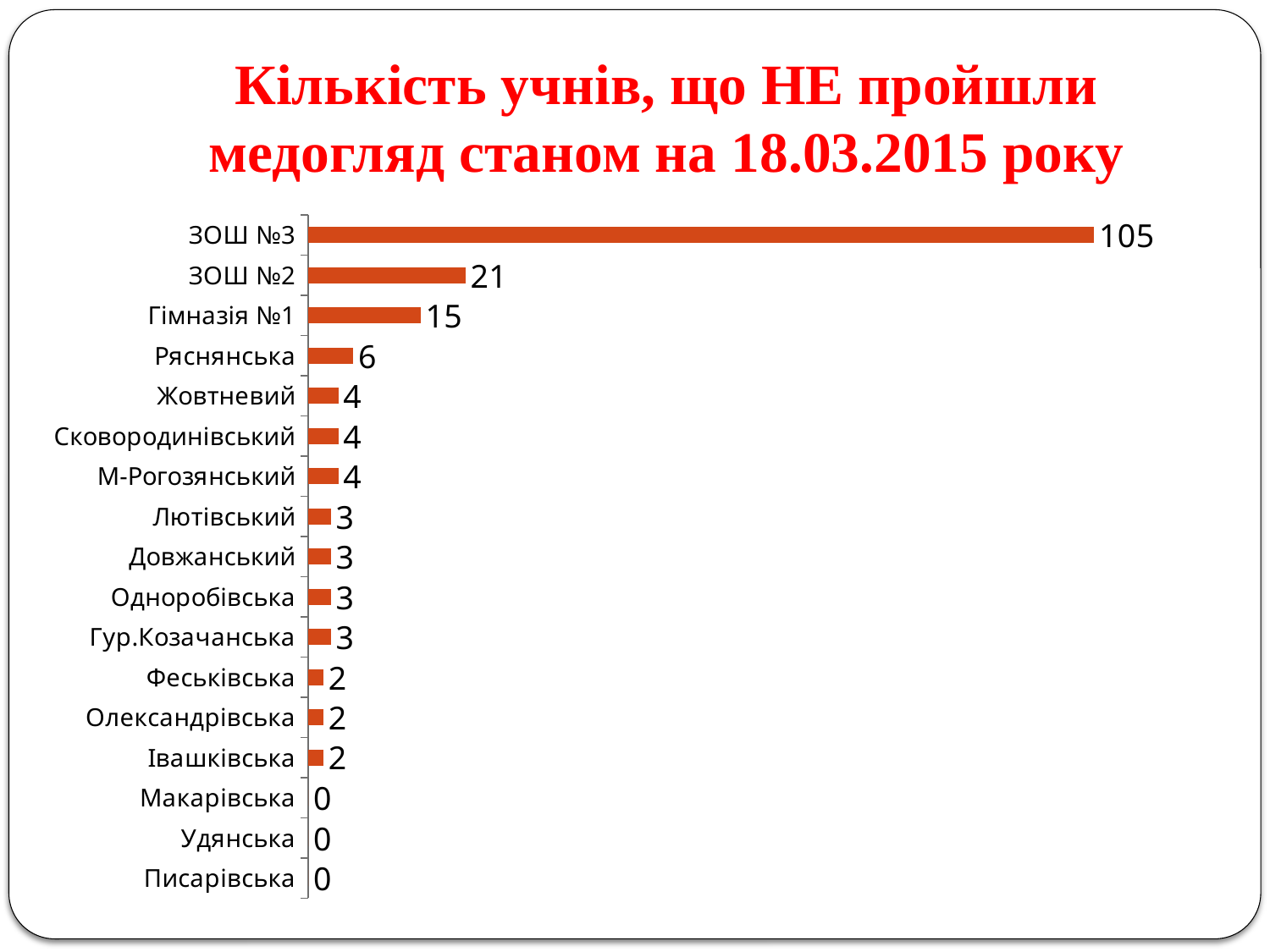
How many categories are shown in the chart? 17 What is the value for ЗОШ №3? 105 What is the title of the chart on the slide? Кількість учнів, що НЕ пройшли медогляд станом на 18.03.2015 року What is the value for Гімназія №1? 15 Which is larger, the value for Ряснянська or the value for Жовтневий? Ряснянська Which category has the highest value? ЗОШ №3 What kind of chart is shown on the slide? Bar chart How many categories have a value of 0? 3 What is the value for Ряснянська? 6 What is the difference between the values for ЗОШ №3 and ЗОШ №2? 84 What is the value for Феськівська? 2 What is the difference between the values for ЗОШ №2 and Гімназія №1? 6